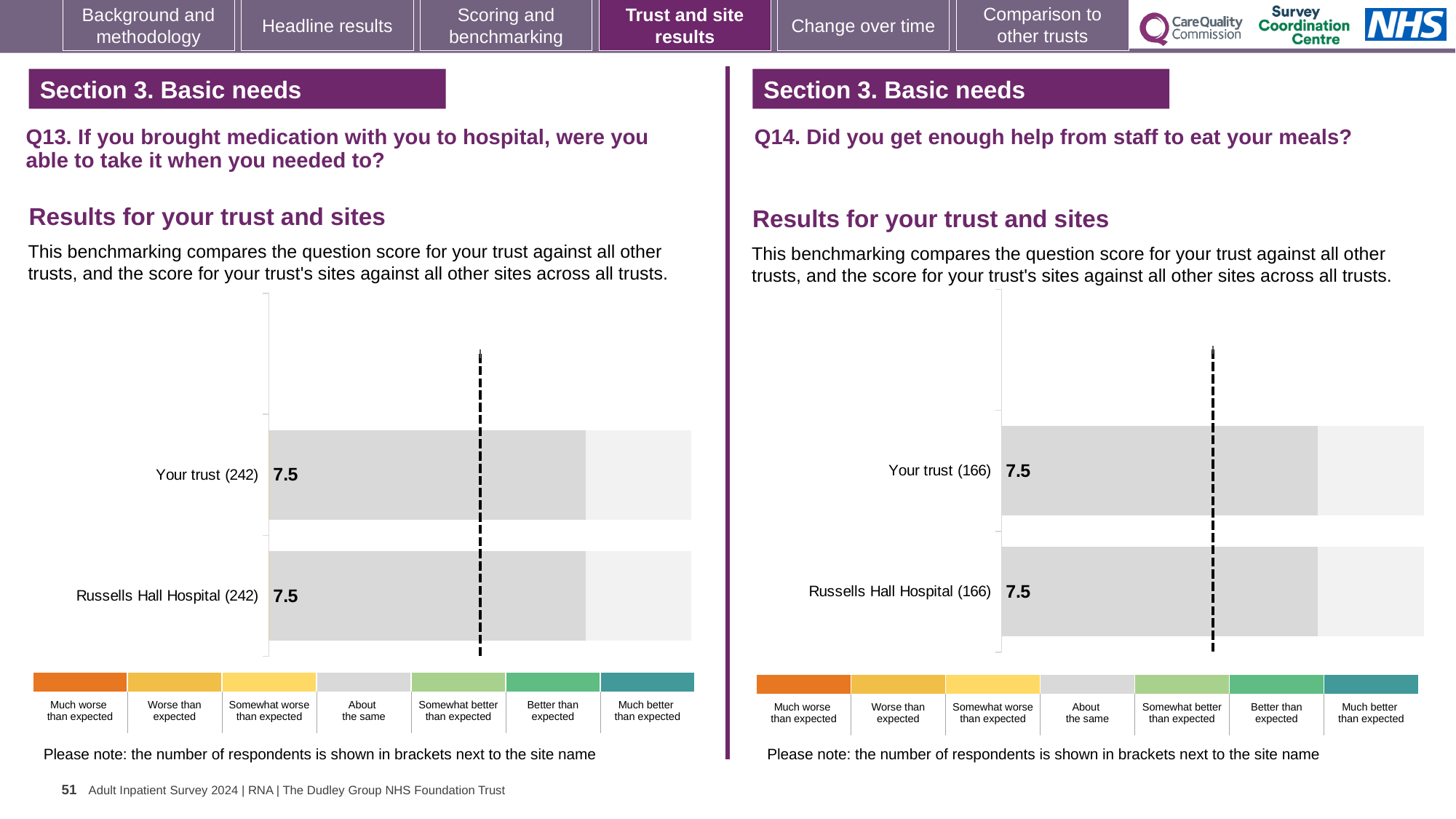
On the Q13 chart (left), what is the score for Russells Hall Hospital? 7.5 What kind of chart is the Q13 chart (left)? Bar chart How many bars are plotted on the Q13 chart (left)? 2 On the Q13 chart (left), what is the difference between the score for Your trust and the score for Russells Hall Hospital? 0.0 On the Q13 chart (left), how many respondents are shown in brackets next to Your trust? 242 On the Q14 chart (right), what is the difference between the score for Your trust and the score for Russells Hall Hospital? 0.0 How many bars are plotted on the Q14 chart (right)? 2 On the Q14 chart (right), how many respondents are shown in brackets next to Russells Hall Hospital? 166 On the Q14 chart (right), is the score for Your trust greater or less than 5? greater On the Q14 chart (right), what is the score for Your trust? 7.5 On the Q13 chart (left), what is the score for Your trust? 7.5 On the Q14 chart (right), what is the score for Russells Hall Hospital? 7.5